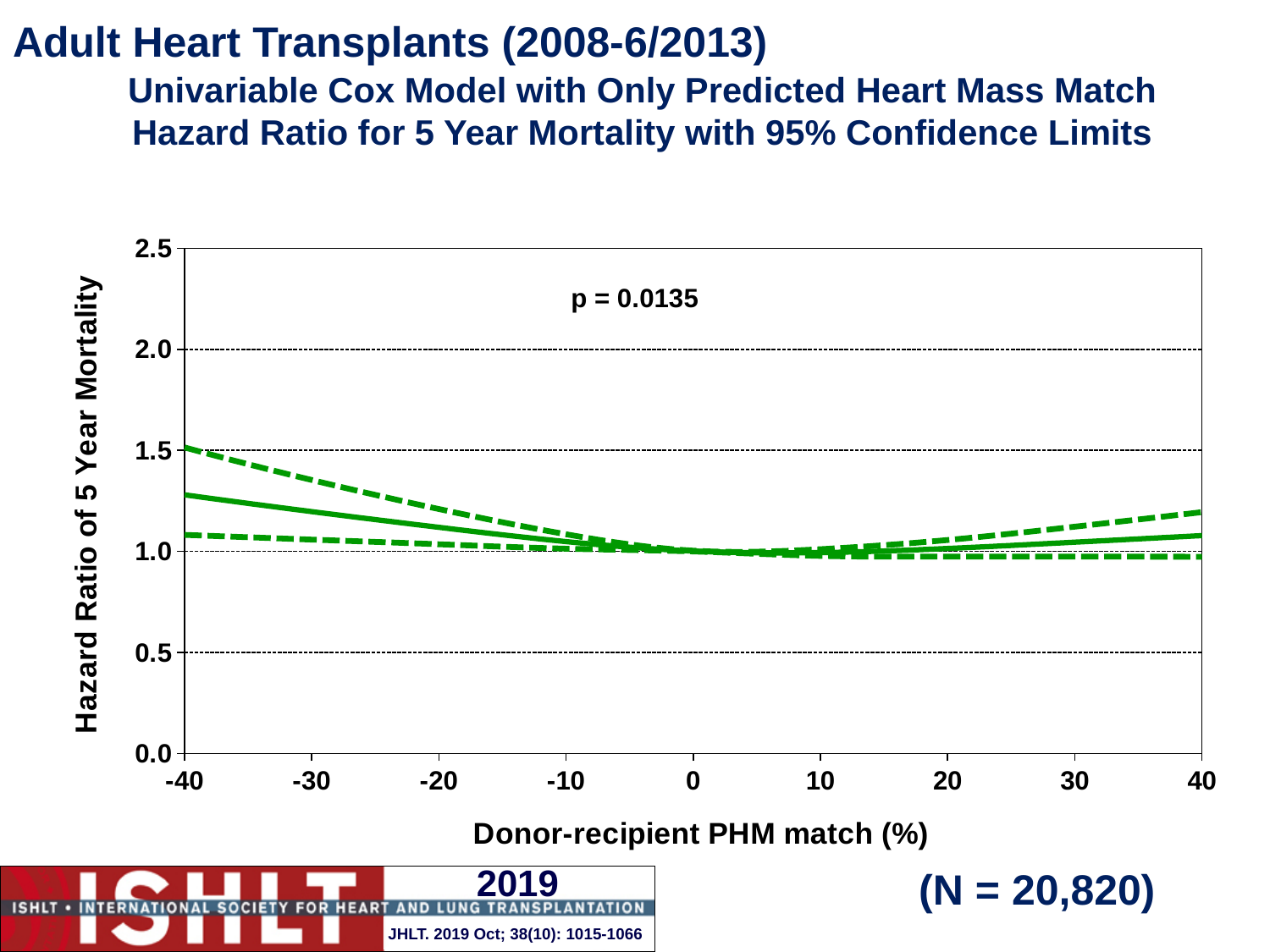
Is the upper 95% confidence limit (upper dashed line) at a donor-recipient PHM match of -40% greater or less than 2.0? less How many lines are plotted on the chart? 3 Does the hazard ratio (solid line) rise or fall as the donor-recipient PHM match goes from -40% to 0%? fall Is the hazard ratio (solid line) at a donor-recipient PHM match of -40% greater or less than 1.5? less Is the hazard ratio (solid line) at a donor-recipient PHM match of 40% greater or less than 1.5? less Is the hazard ratio (solid line) higher at a donor-recipient PHM match of -40% or at 40%? -40% What kind of chart is shown on the slide? line chart What p-value is printed on the chart? p = 0.0135 How many tick labels are shown on the x axis? 9 What is the label of the x axis? Donor-recipient PHM match (%)